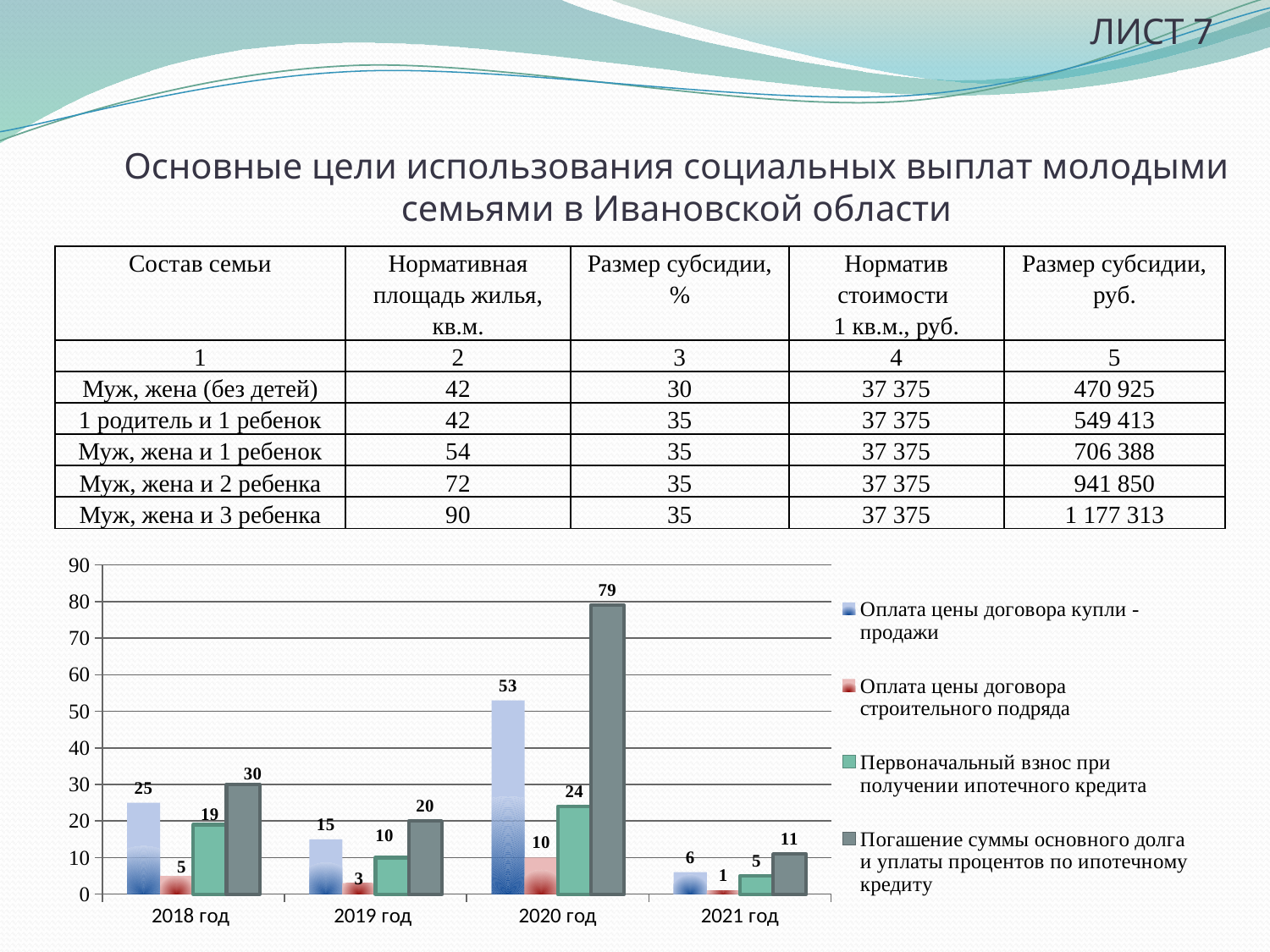
What type of chart is shown on the slide? Bar chart What is the value for 'Оплата цены договора строительного подряда' in 2021 год? 1 What is the value for 'Оплата цены договора купли - продажи' in 2018 год? 25 Which series is shown in red in the chart legend? Оплата цены договора строительного подряда What is the difference between the values for 'Погашение суммы основного долга и уплаты процентов по ипотечному кредиту' and 'Оплата цены договора купли - продажи' in 2020 год? 26 In which year is the value for 'Оплата цены договора купли - продажи' highest? 2020 год Which is larger in 2018 год: 'Первоначальный взнос при получении ипотечного кредита' or 'Оплата цены договора купли - продажи'? Оплата цены договора купли - продажи What is the value for 'Первоначальный взнос при получении ипотечного кредита' in 2019 год? 10 How many series does the chart legend list? 4 What is the value for 'Погашение суммы основного долга и уплаты процентов по ипотечному кредиту' in 2020 год? 79 In which year is the value for 'Погашение суммы основного долга и уплаты процентов по ипотечному кредиту' lowest? 2021 год How many year categories are shown on the x axis of the chart? 4